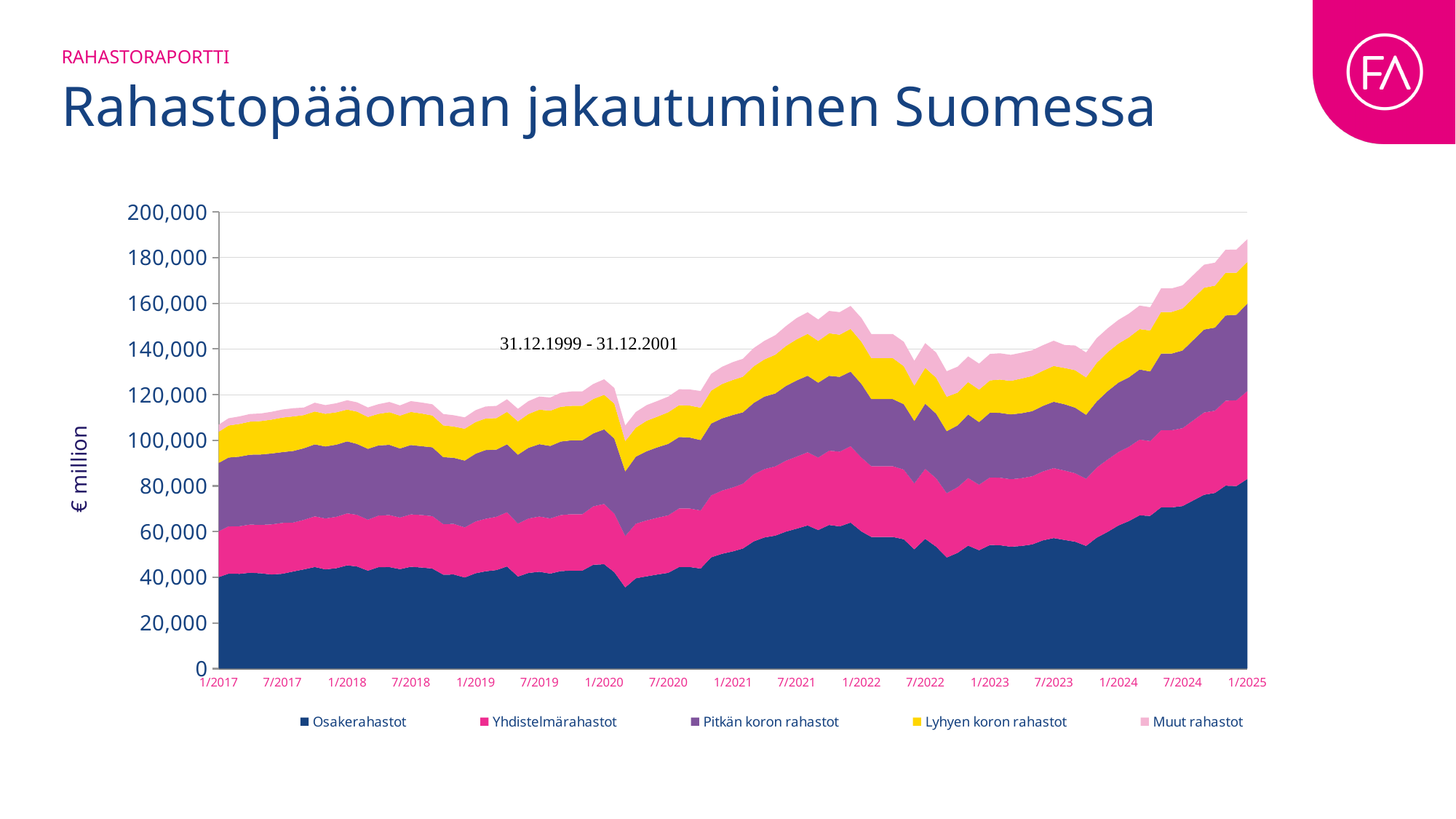
Which series has the largest value at 1/2025? Osakerahastot Is the total fund capital at 1/2025 greater or less than 180,000? greater Is the total fund capital at 1/2017 greater or less than 120,000? less What kind of chart is shown on the slide? Stacked area chart How many date labels are shown on the x axis? 17 Is the value for Osakerahastot at 1/2025 greater or less than 60,000? greater Which series is shown in dark blue at the bottom of the stack? Osakerahastot What is the unit shown on the vertical axis label? € million Does the total fund capital rise or fall overall from 1/2017 to 1/2025? rise How many series does the legend list? 5 At which x-axis date does the total fund capital reach its highest level? 1/2025